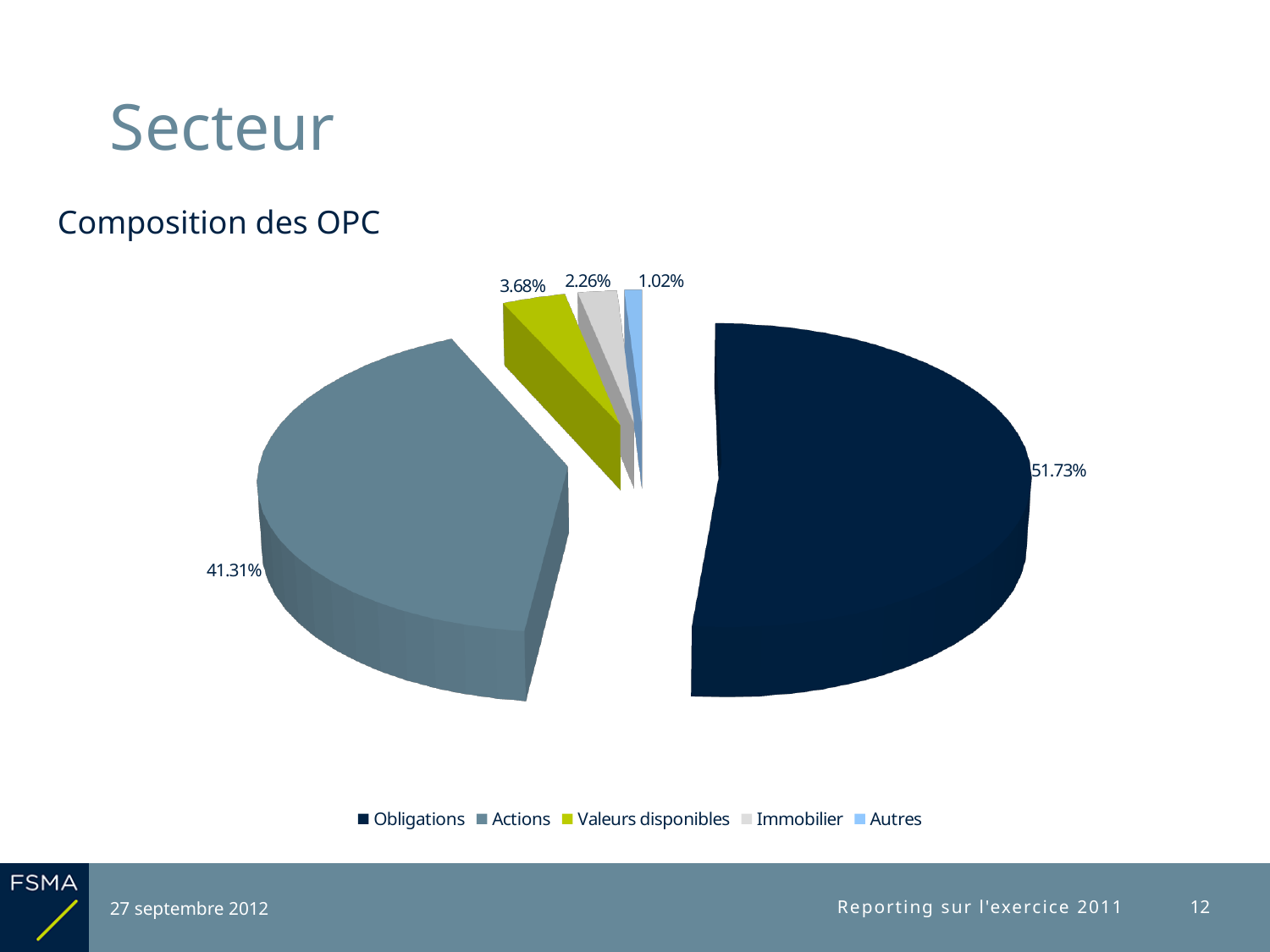
What share of the pie does Actions represent? 41.31% Which is larger, Immobilier or Autres? Immobilier Which category has the largest slice of the pie? Obligations How many categories are shown in the pie chart? 5 Which category has the smallest slice of the pie? Autres What is the difference in percentage points between Obligations and Actions? 10.42% What is the value shown for Autres? 1.02% What is the value shown for Immobilier? 2.26% What share of the pie does Obligations represent? 51.73% What is the difference between Valeurs disponibles and Immobilier? 1.42% What is the value shown for Valeurs disponibles? 3.68% What kind of chart is shown on the slide? Pie chart